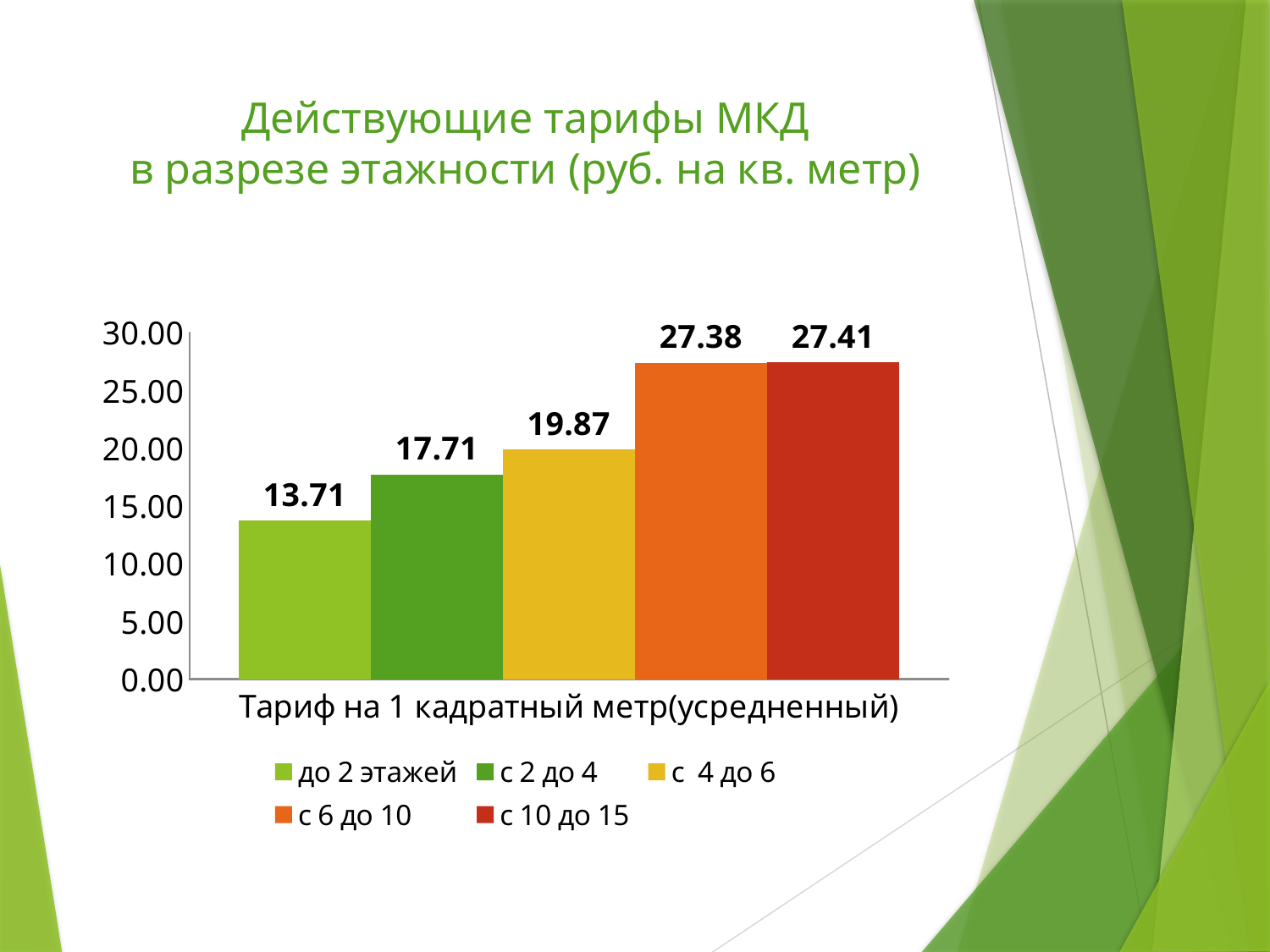
What is the tariff value for the series 'с 6 до 10'? 27.38 What is the difference between the tariff for 'с 4 до 6' and the tariff for 'до 2 этажей'? 6.16 Which series has the highest tariff value? с 10 до 15 Which is larger, the tariff for 'с 2 до 4' or the tariff for 'с 6 до 10'? с 6 до 10 What is the tariff value for the series 'с 10 до 15'? 27.41 How many series does the legend list? 5 What kind of chart is shown on the slide? Bar chart Which series has the lowest tariff value? до 2 этажей What is the difference between the tariff for 'с 6 до 10' and the tariff for 'с 4 до 6'? 7.51 What is the tariff value for the series 'с 4 до 6'? 19.87 What is the tariff value for the series 'с 2 до 4'? 17.71 What is the tariff value for the series 'до 2 этажей'? 13.71